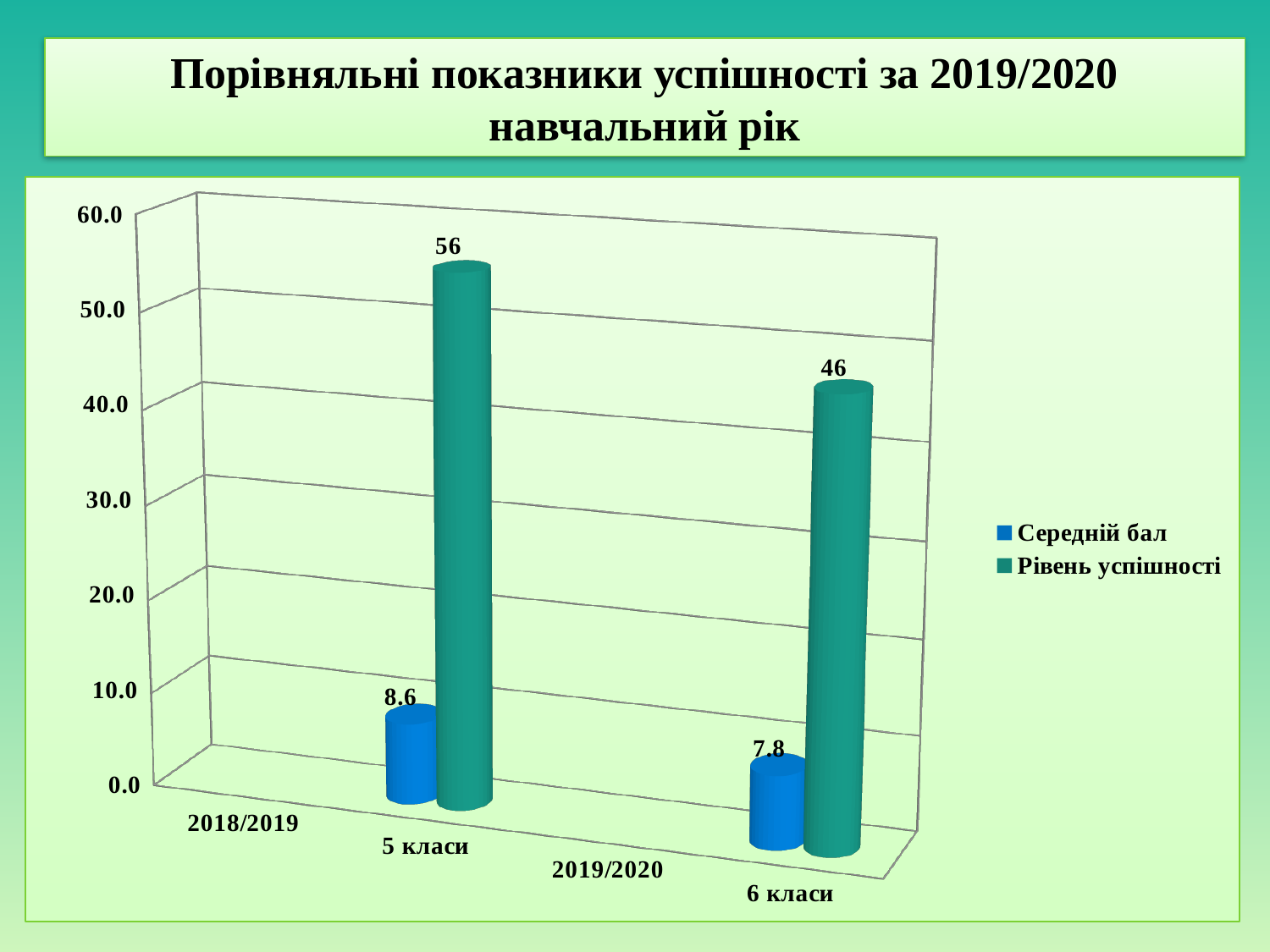
What is the difference in Рівень успішності between 2018/2019 5 класи and 2019/2020 6 класи? 10 Is the Середній бал for 2018/2019 5 класи larger or smaller than for 2019/2020 6 класи? larger Which category has the lower Середній бал? 2019/2020 6 класи Is the Рівень успішності for 2019/2020 6 класи greater or less than 50.0? less What is the value of Середній бал for 2018/2019 5 класи? 8.6 What is the value of Рівень успішності for 2018/2019 5 класи? 56 How many series does the legend list? 2 What is the value of Середній бал for 2019/2020 6 класи? 7.8 What colour are the Рівень успішності bars? green Which category has the higher Рівень успішності? 2018/2019 5 класи What kind of chart is shown on the slide? bar chart What is the value of Рівень успішності for 2019/2020 6 класи? 46